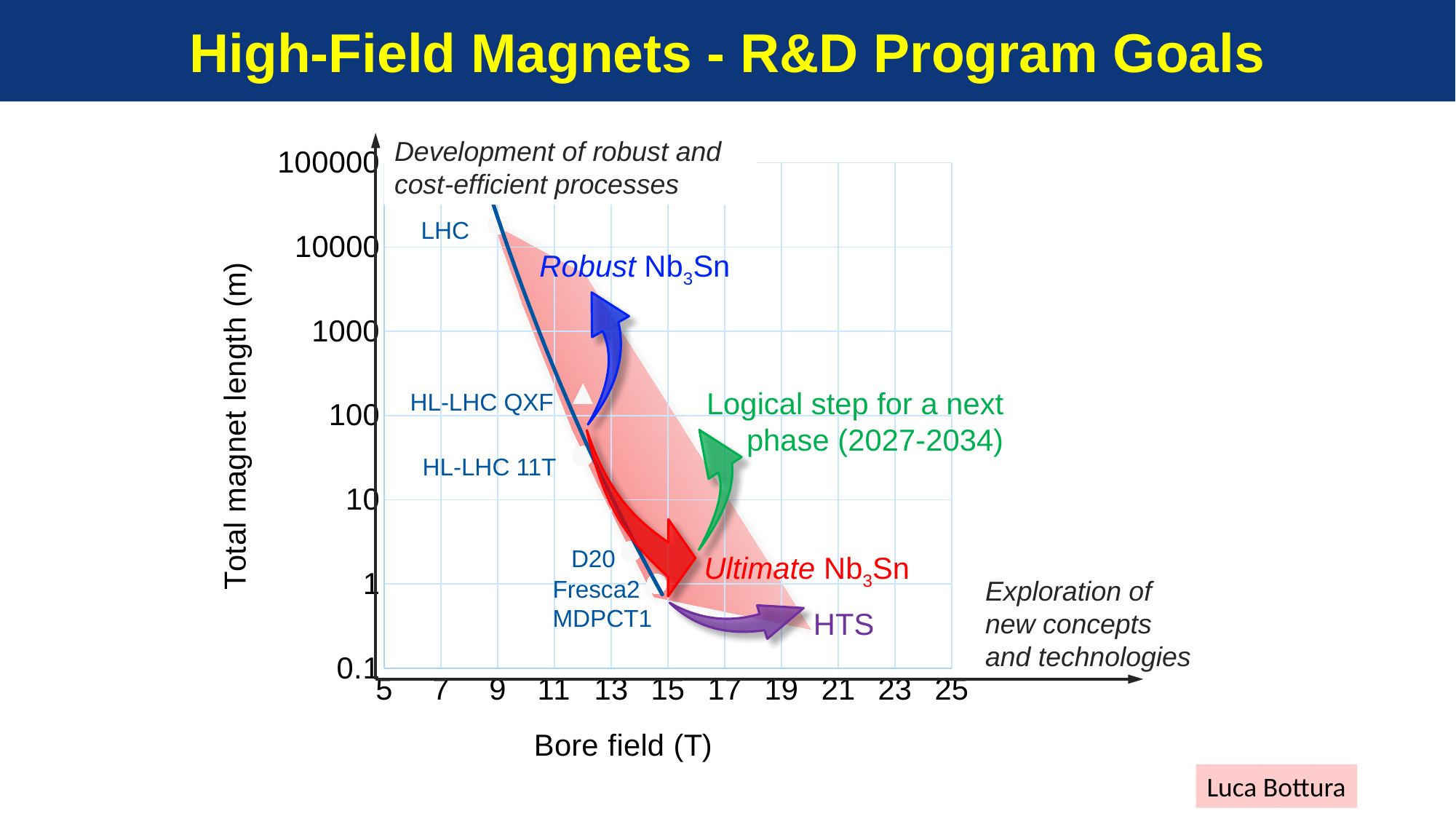
Is the total magnet length for HL-LHC 11T greater or less than 100? less Is the total magnet length for D20 greater or less than 10? less What is the title of the x axis? Bore field (T) What kind of chart is shown on the slide? scatter chart Is the total magnet length for LHC greater or less than 1000? greater What is the title of the y axis? Total magnet length (m) Which labeled magnet has the highest total magnet length? LHC Which has the larger total magnet length, LHC or HL-LHC 11T? LHC Which labeled magnet has the lowest bore field? LHC Which has the larger bore field, LHC or D20? D20 As bore field increases along the x axis, does total magnet length rise or fall? fall